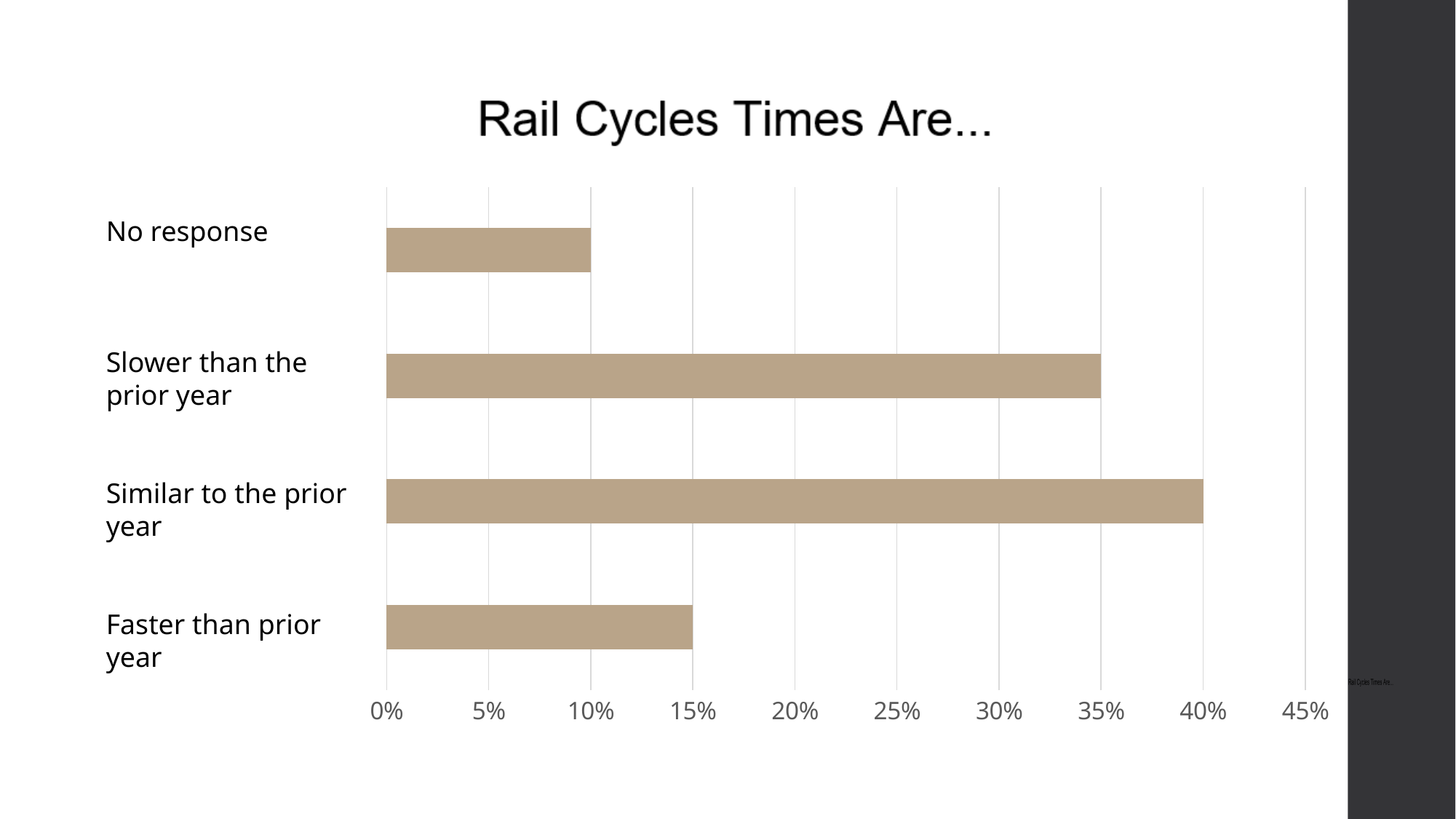
What is the title of the chart? Rail Cycles Times Are... What is the value for "Faster than prior year"? 15% What is the difference between the values for "Similar to the prior year" and "Slower than the prior year"? 5% Which is larger, the value for "Faster than prior year" or the value for "No response"? Faster than prior year Which category has the highest value? Similar to the prior year What is the value for "Similar to the prior year"? 40% What kind of chart is shown on the slide? bar chart How many categories are shown in the chart? 4 What is the value for "No response"? 10% Is the value for "Slower than the prior year" greater or less than 30%? greater What is the value for "Slower than the prior year"? 35% Which category has the lowest value? No response